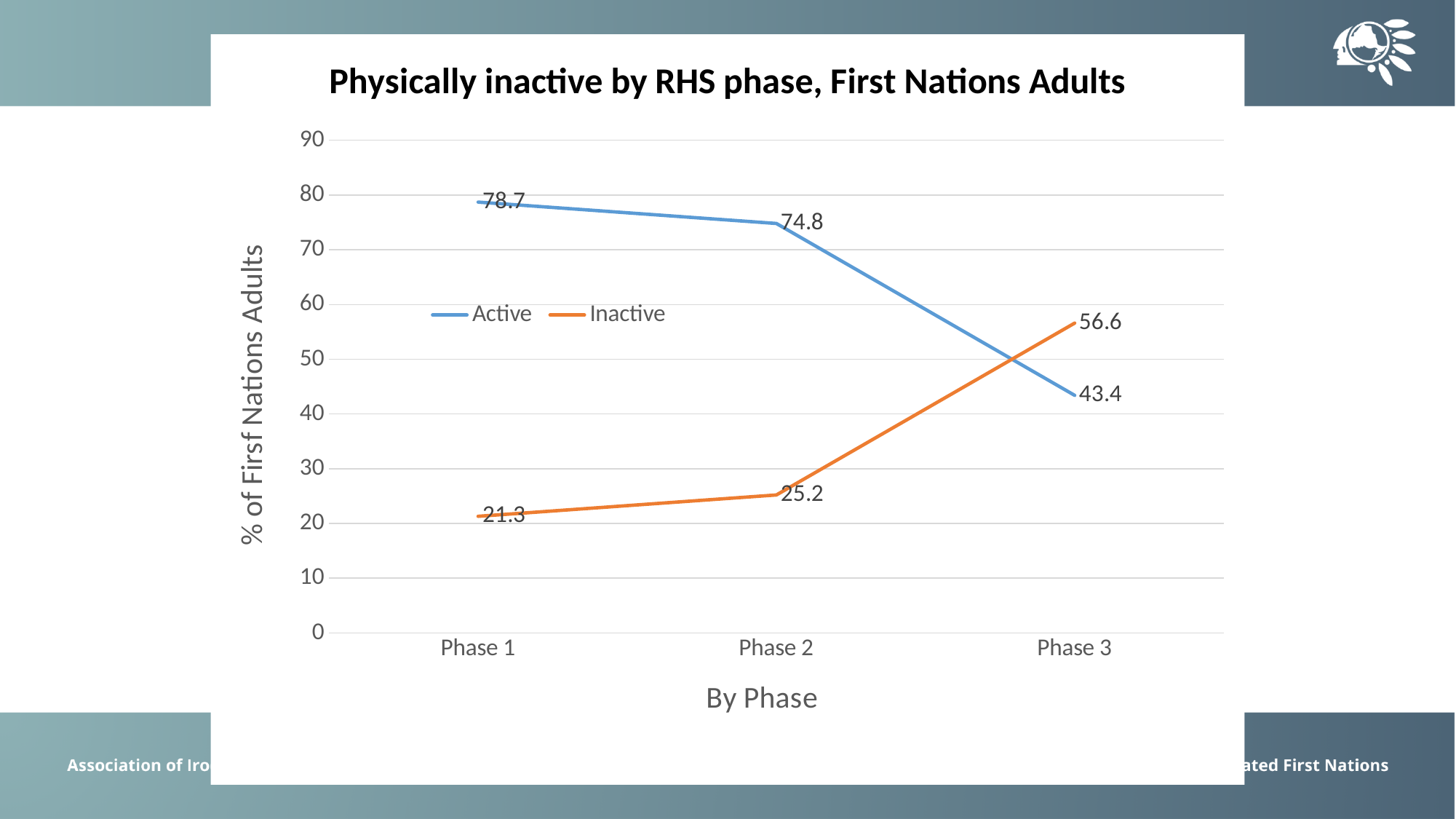
In which phase is the Active value lowest? Phase 3 What is the value for Inactive in Phase 3? 56.6 What is the title of the chart? Physically inactive by RHS phase, First Nations Adults How many phases are shown on the x axis? 3 Does the Active series rise or fall from Phase 1 to Phase 3? Fall What kind of chart is shown? Line chart What is the value for Inactive in Phase 2? 25.2 How many series does the legend list? 2 In which phase is the Inactive value highest? Phase 3 Which is larger in Phase 3, the Active value or the Inactive value? Inactive What is the value for Active in Phase 1? 78.7 What is the difference between the Active and Inactive values in Phase 1? 57.4